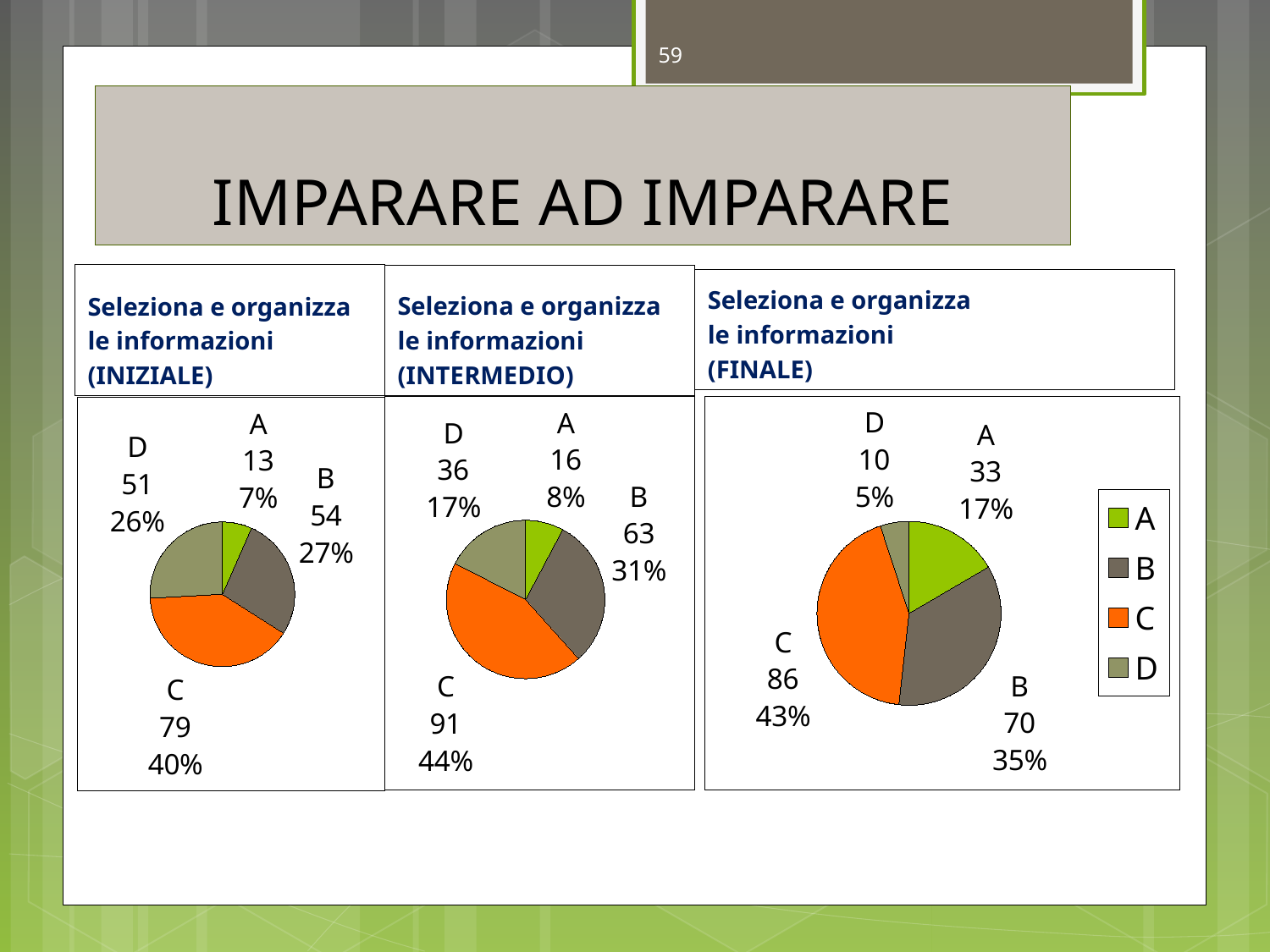
In the INIZIALE chart, what is the value for category C? 79 How many categories does the INIZIALE chart show? 4 In the INTERMEDIO chart, what is the value for category B? 63 What type of chart is used in the FINALE panel? Pie chart In the INTERMEDIO chart, what percentage share does category D have? 17% In the INTERMEDIO chart, which category has the largest slice? C In the FINALE chart, which is larger, the value for B or the value for A? B In the FINALE chart, what is the difference between the values for C and B? 16 How many entries does the legend next to the FINALE chart list? 4 In the INIZIALE chart, what percentage share does category A have? 7% In the FINALE chart, what is the value for category A? 33 In the FINALE chart, which category has the smallest slice? D